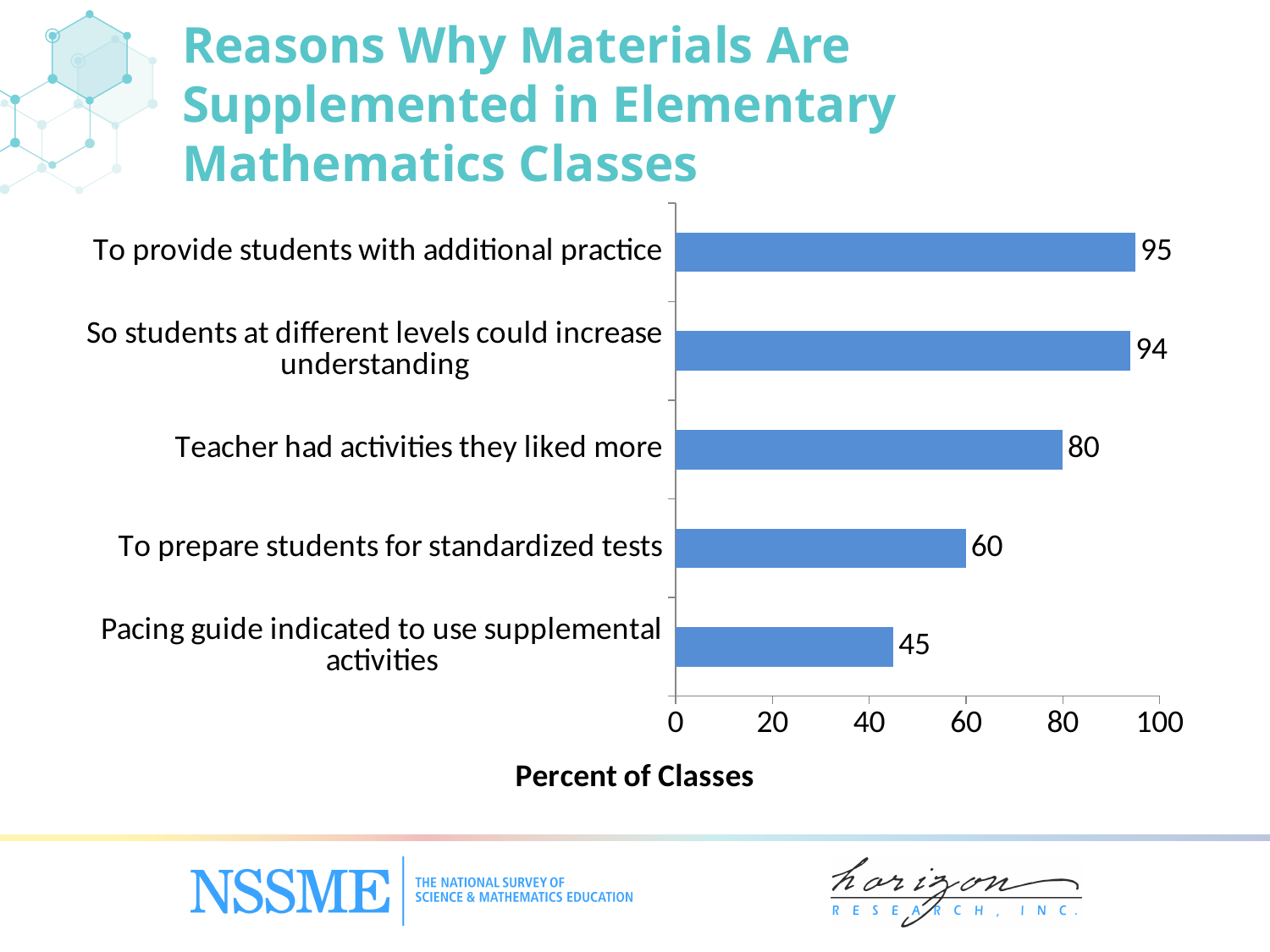
Which reason has the lowest percent of classes? Pacing guide indicated to use supplemental activities What is the label of the horizontal axis? Percent of Classes What is the value for "Teacher had activities they liked more"? 80 What is the value for "Pacing guide indicated to use supplemental activities"? 45 Is the value for "Pacing guide indicated to use supplemental activities" greater or less than 60? less What kind of chart is shown on the slide? bar chart Which reason has the highest percent of classes? To provide students with additional practice How many reasons are shown in the chart? 5 What is the difference between the values for "Teacher had activities they liked more" and "To prepare students for standardized tests"? 20 What is the value for "To provide students with additional practice"? 95 What is the value for "To prepare students for standardized tests"? 60 Which is larger: the value for "So students at different levels could increase understanding" or the value for "Teacher had activities they liked more"? So students at different levels could increase understanding